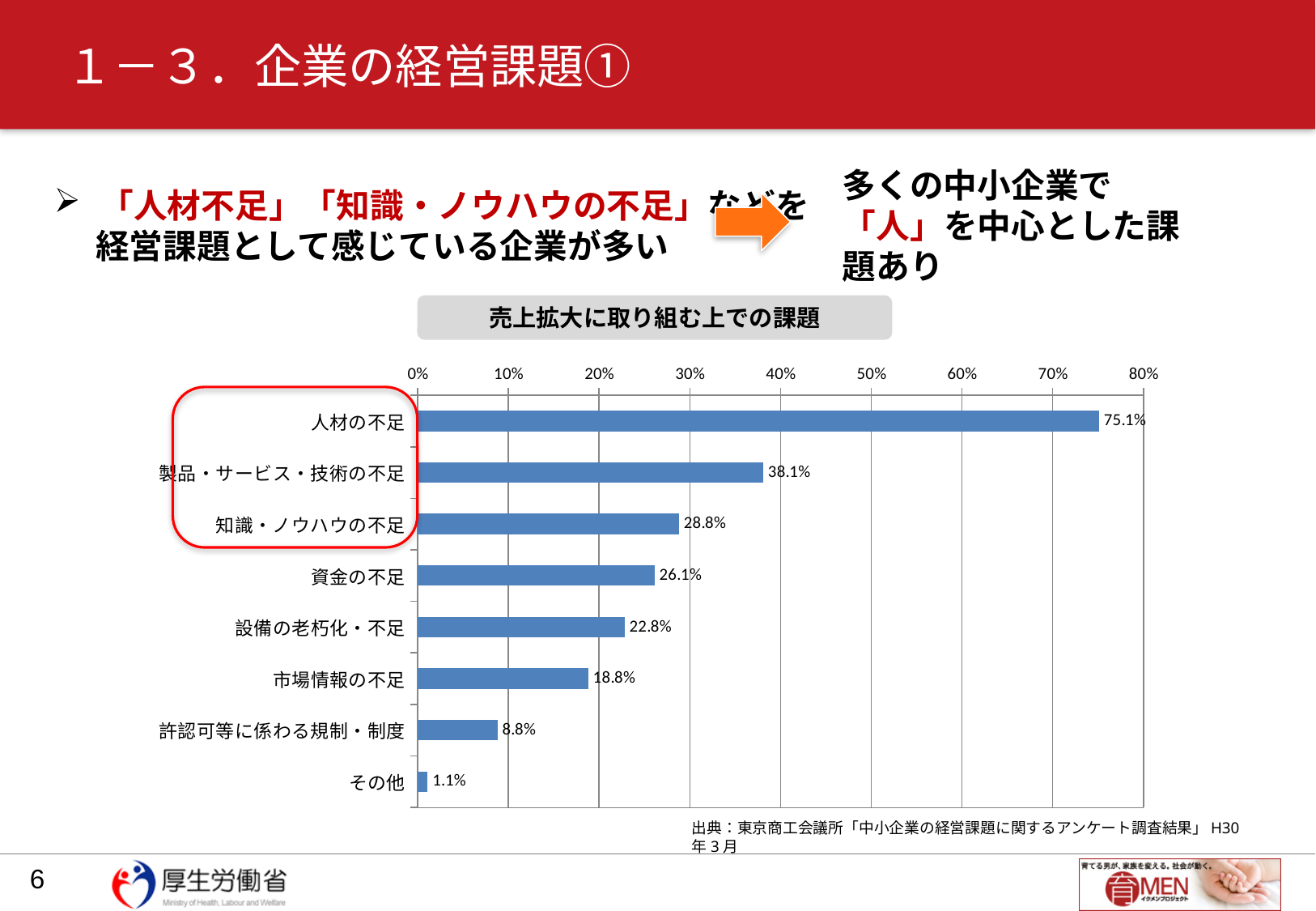
Which is larger, 市場情報の不足 or 設備の老朽化・不足? 設備の老朽化・不足 How many categories are shown in the chart? 8 What kind of chart is shown on the slide? bar chart Which category has the lowest value? その他 What is the value for 人材の不足? 75.1% Is the value for 製品・サービス・技術の不足 greater or less than 40%? less What is the difference between 人材の不足 and 製品・サービス・技術の不足? 37.0% What is the value for 知識・ノウハウの不足? 28.8% What is the difference between 資金の不足 and 設備の老朽化・不足? 3.3% What is the value for 許認可等に係わる規制・制度? 8.8% Which category has the highest value? 人材の不足 What is the title of the chart? 売上拡大に取り組む上での課題